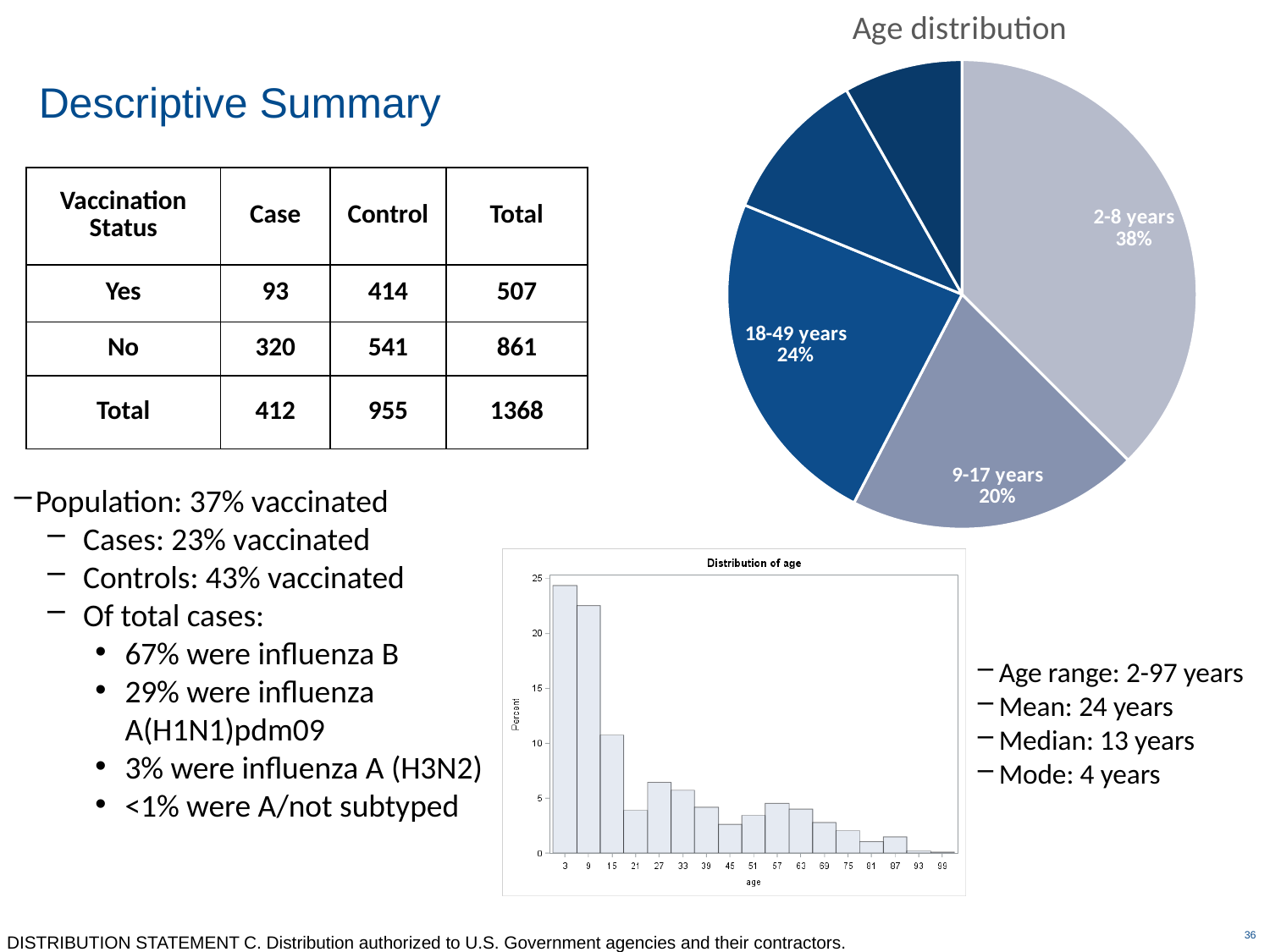
What kind of chart is the Distribution of age chart at the bottom of the slide? Bar chart In the Age distribution pie chart, what share is shown for the 18-49 years slice? 24% In the Age distribution pie chart, which slice is larger, 18-49 years or 9-17 years? 18-49 years In the Age distribution pie chart, what share is shown for the 9-17 years slice? 20% In the Age distribution pie chart, what share is shown for the 2-8 years slice? 38% In the Distribution of age chart, which age bin has the tallest bar? 3 In the Age distribution pie chart, how many percentage points larger is the 2-8 years slice than the 9-17 years slice? 18 percentage points In the Distribution of age chart, is the value for age 3 greater or less than 20? greater In the Distribution of age chart, do the bar heights generally rise or fall as age increases? Fall In the Age distribution pie chart, which age group has the largest slice? 2-8 years What kind of chart is the Age distribution chart? Pie chart How many slices does the Age distribution pie chart have? 5